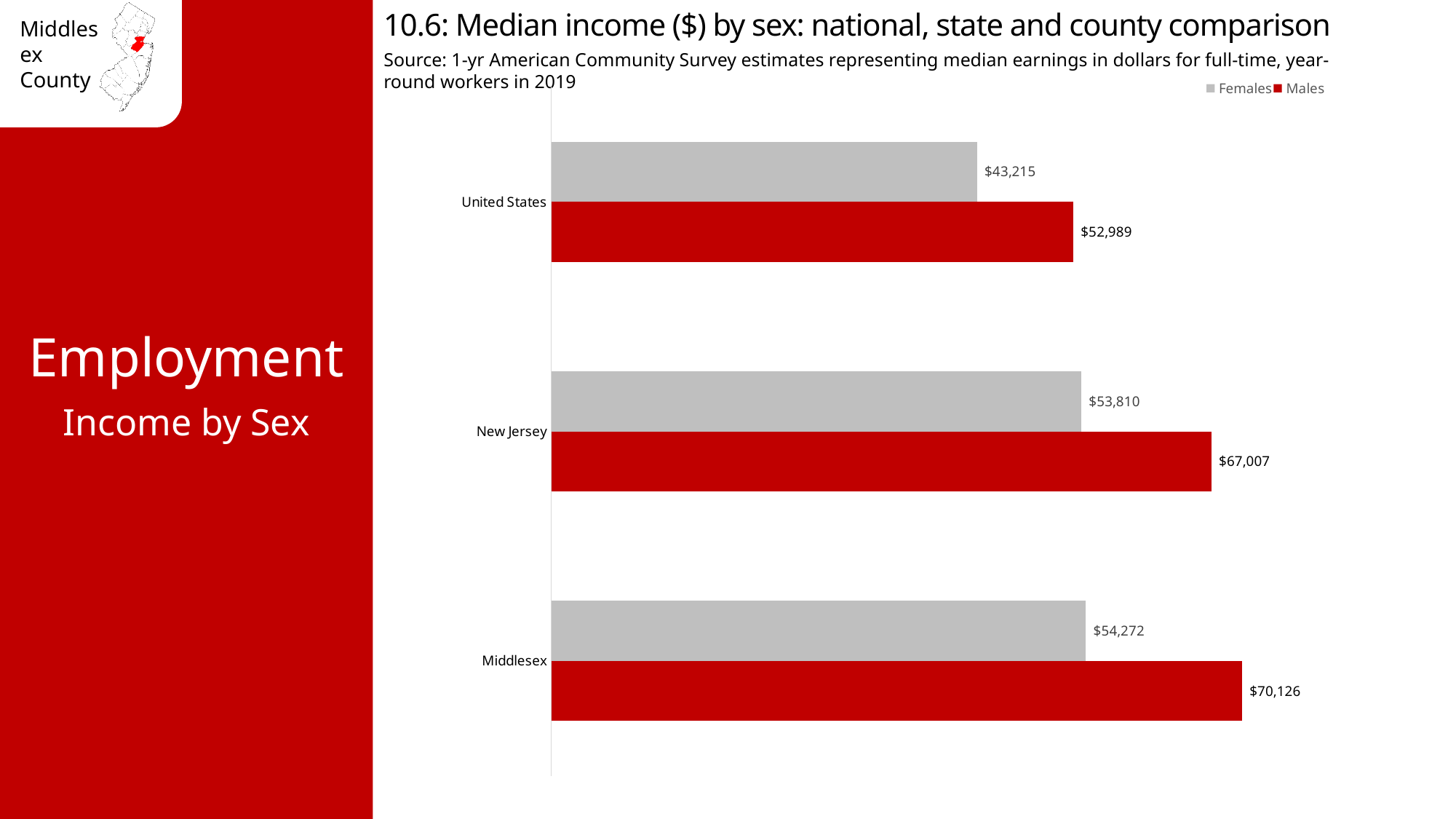
What type of chart is shown on the slide? Bar chart What is the median income for females in Middlesex? $54,272 What is the difference between male and female median income in Middlesex? $15,854 How many series does the legend list? 2 Which category has the lowest median income for females? United States What is the difference between male median income in New Jersey and in the United States? $14,018 What is the median income for males in the United States? $52,989 What is the median income for females in the United States? $43,215 Which is larger: female median income in New Jersey or male median income in the United States? Female median income in New Jersey How many geographic categories are shown on the chart? 3 Which category has the highest median income for males? Middlesex What is the median income for males in New Jersey? $67,007